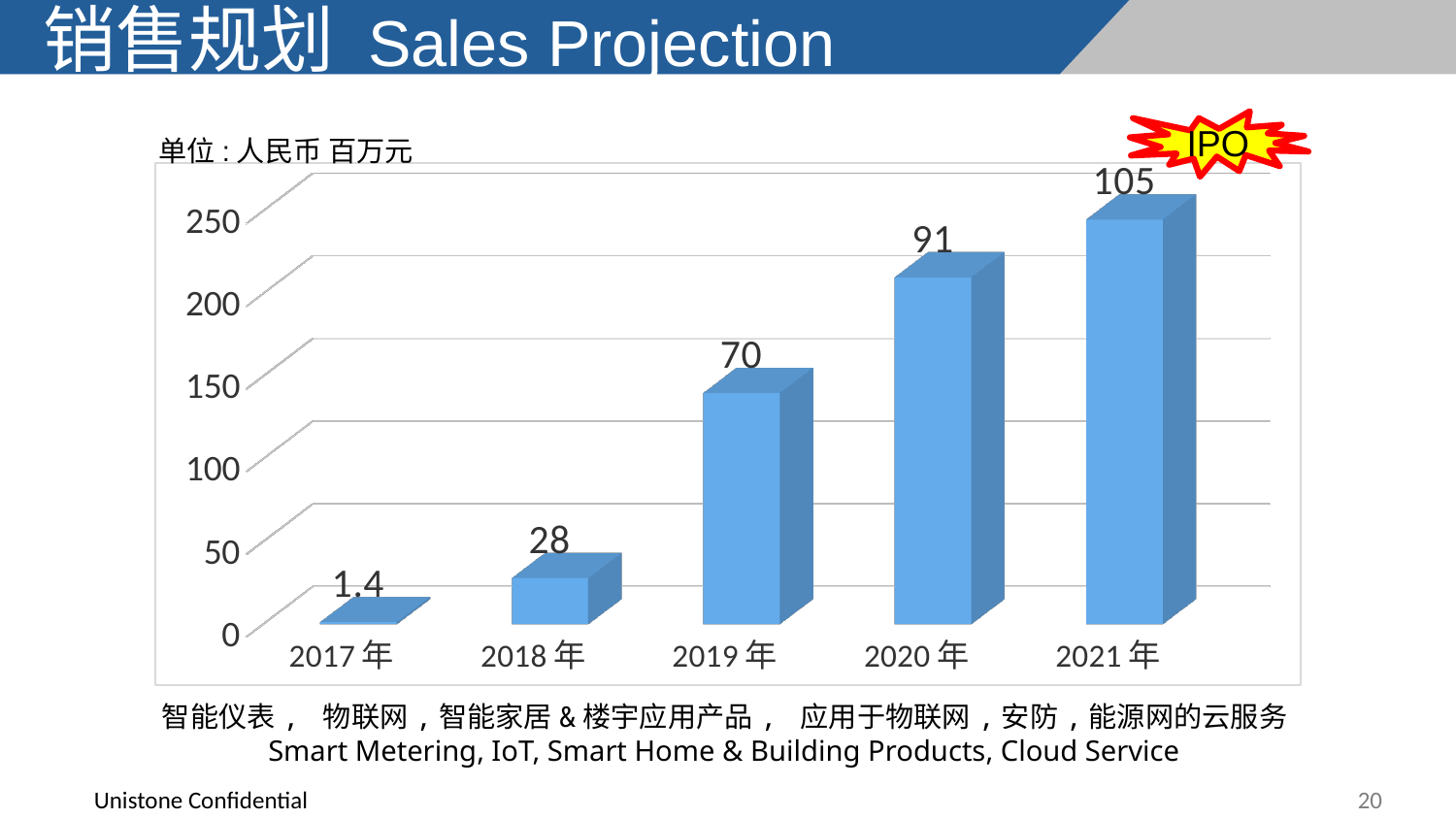
What is the difference between the values for 2018 年 and 2017 年? 26.6 What is the value for 2021 年? 105 Which is larger, the value for 2018 年 or the value for 2020 年? 2020 年 Do the values rise or fall from 2017 年 to 2021 年? rise Which year has the highest value? 2021 年 How many years are shown on the x axis? 5 What is the value for 2017 年? 1.4 What unit is stated above the chart? 人民币 百万元 What is the value for 2019 年? 70 Which year has the lowest value? 2017 年 What is the difference between the values for 2020 年 and 2019 年? 21 What kind of chart is shown on the slide? bar chart